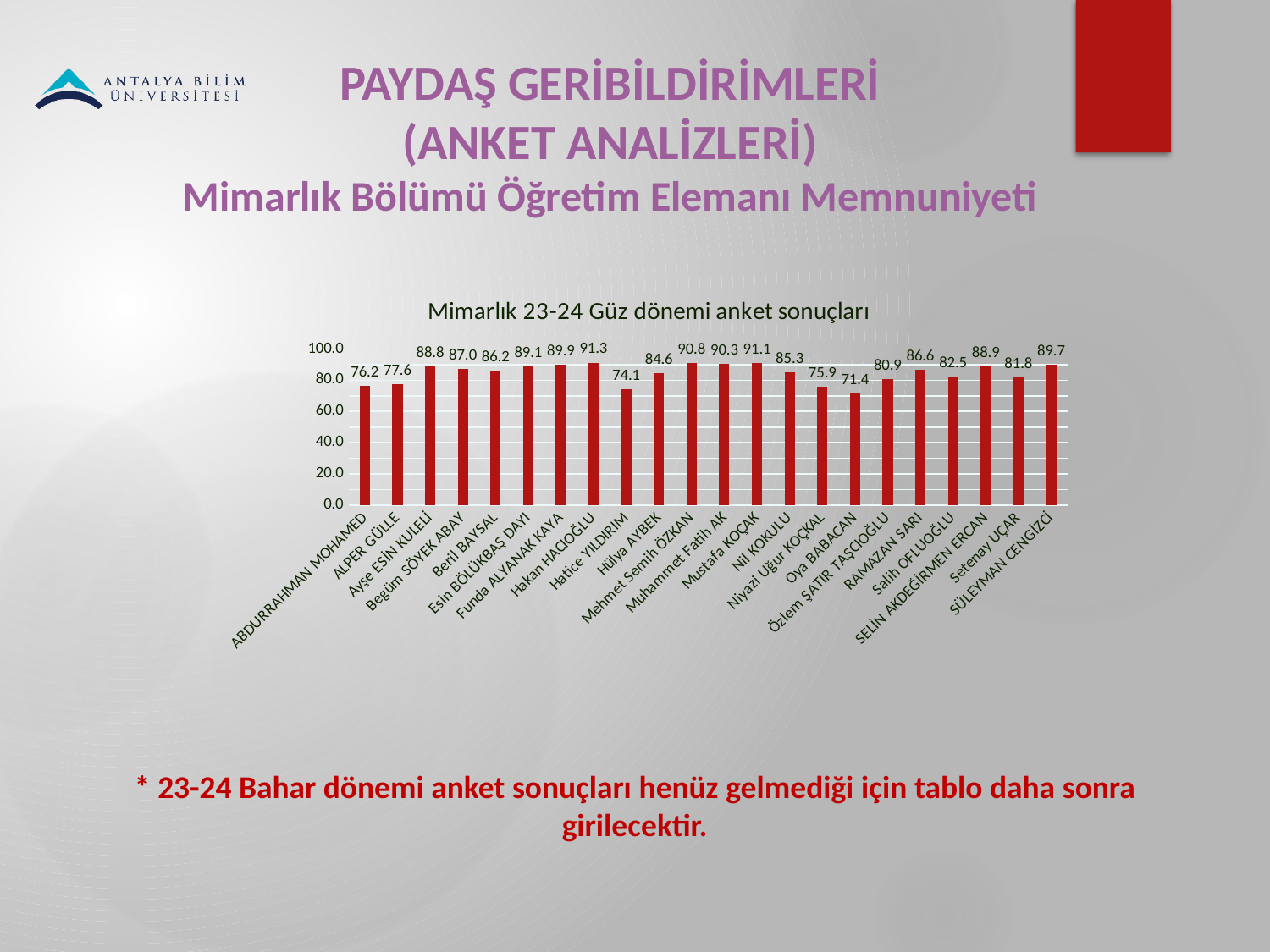
Which category has the highest value? Hakan HACIOĞLU Which is larger, the value for Ayşe ESİN KULELİ or the value for Hülya AYBEK? Ayşe ESİN KULELİ What is the value for Hatice YILDIRIM? 74.1 What is the title of the chart? Mimarlık 23-24 Güz dönemi anket sonuçları How many categories are shown on the x axis? 22 What kind of chart is shown on the slide? Bar chart Which category has the lowest value? Oya BABACAN What is the value for Setenay UÇAR? 81.8 Is the value for Niyazi Uğur KOÇKAL greater or less than 80.0? less What is the value for Oya BABACAN? 71.4 What is the difference between the values for Hakan HACIOĞLU and Oya BABACAN? 19.9 What is the value for Hakan HACIOĞLU? 91.3